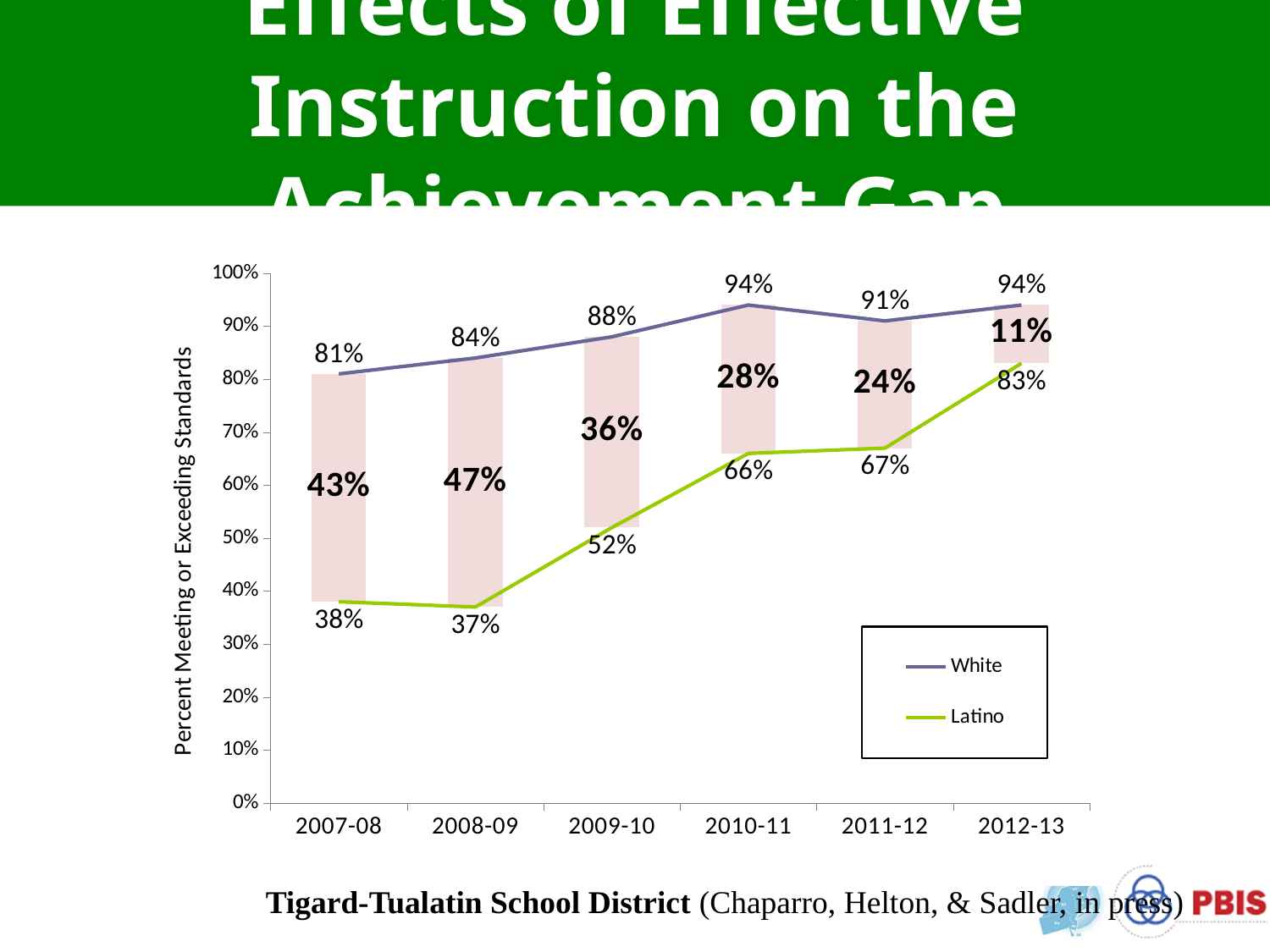
What is the value for Latino in 2012-13? 83% What kind of chart is shown on the slide? Combination bar and line chart In which year is the Latino value lowest? 2008-09 What is the value for Latino in 2009-10? 52% How many school years are shown on the x axis? 6 What is the value for White in 2007-08? 81% What is the value for White in 2011-12? 91% What is the difference between the White and Latino values in 2008-09? 47% What is the difference between the White and Latino values in 2010-11? 28% Does the Latino value rise or fall from 2009-10 to 2012-13? Rise How many series does the legend list? 2 Which is larger in 2011-12, the White value or the Latino value? White